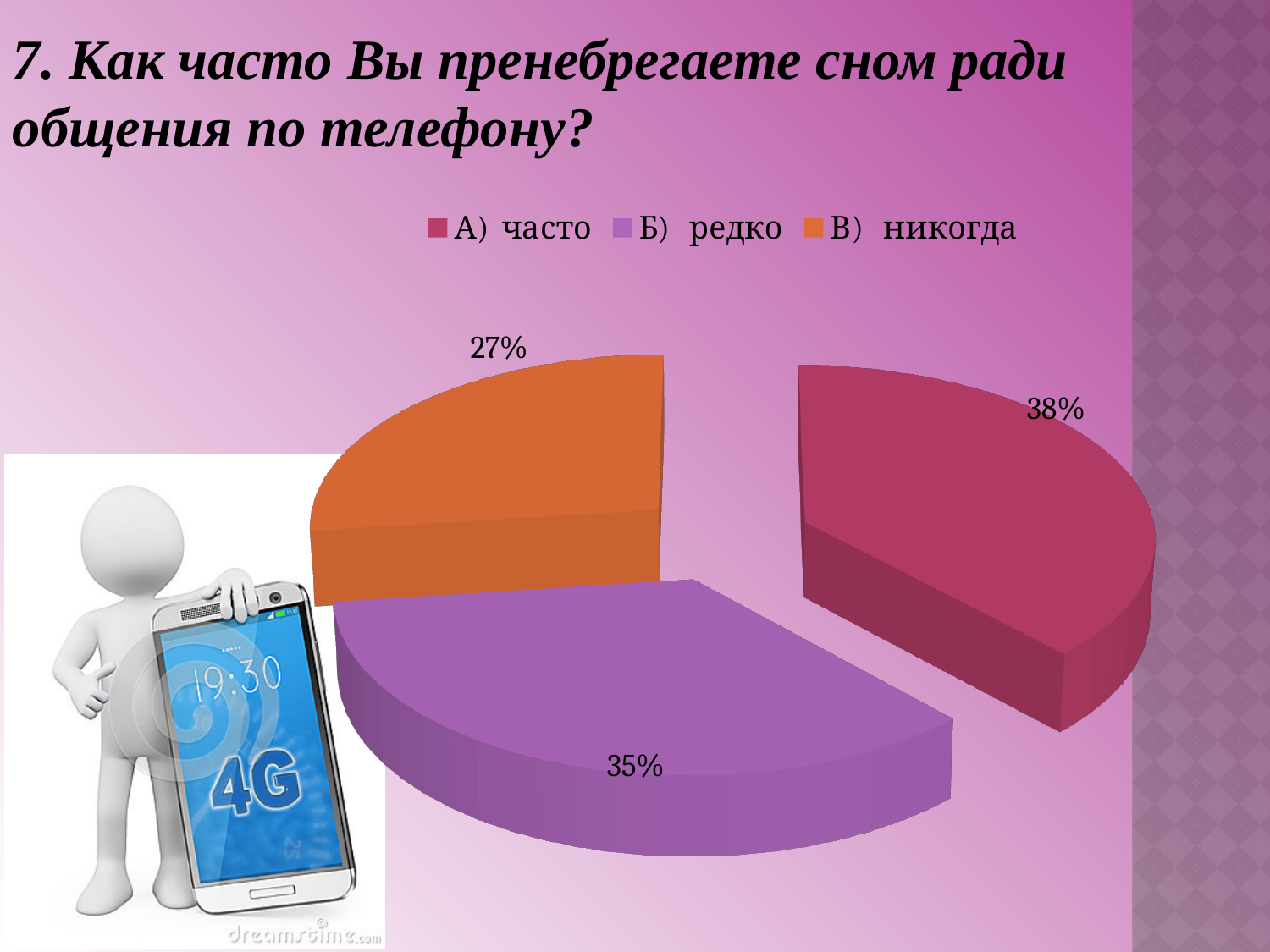
What is the difference between the shares for "А) часто" and "В) никогда"? 11% Which category has the smallest share of the pie? В) никогда How many entries does the legend list? 3 Which category has the largest share of the pie? А) часто What colour is the slice for "В) никогда"? orange What percentage is shown for "Б) редко"? 35% Which is larger, the share for "Б) редко" or the share for "В) никогда"? Б) редко What is the difference between the shares for "Б) редко" and "В) никогда"? 8% How many slices does the pie chart have? 3 What percentage is shown for "В) никогда"? 27% What percentage is shown for "А) часто"? 38% What kind of chart is shown on the slide? pie chart